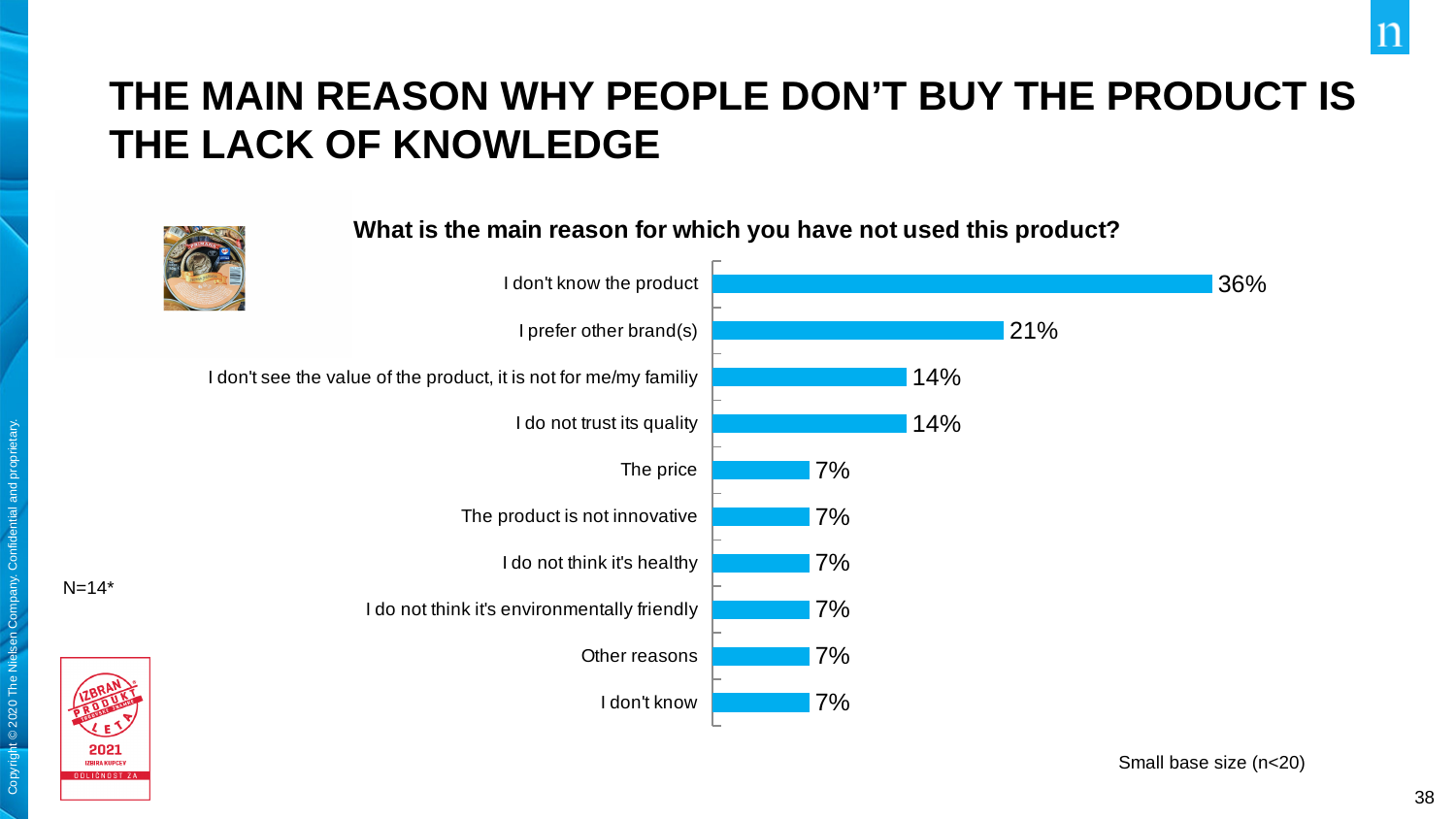
What is the question shown as the chart's title? What is the main reason for which you have not used this product? Which reason has the highest percentage? I don't know the product How many categories share the lowest value of 7%? 6 Which is larger: "I prefer other brand(s)" or "I don't see the value of the product, it is not for me/my familiy"? I prefer other brand(s) What kind of chart is shown on the slide? Bar chart What percentage of respondents said "I don't know the product" as their main reason for not using the product? 36% What is the value for "The price"? 7% What is the value for "I do not trust its quality"? 14% How many reasons (categories) are shown in the chart? 10 What is the difference between "I prefer other brand(s)" and "I do not trust its quality"? 7% What is the value for "I prefer other brand(s)"? 21% What is the difference between "I don't know the product" and "I prefer other brand(s)"? 15%